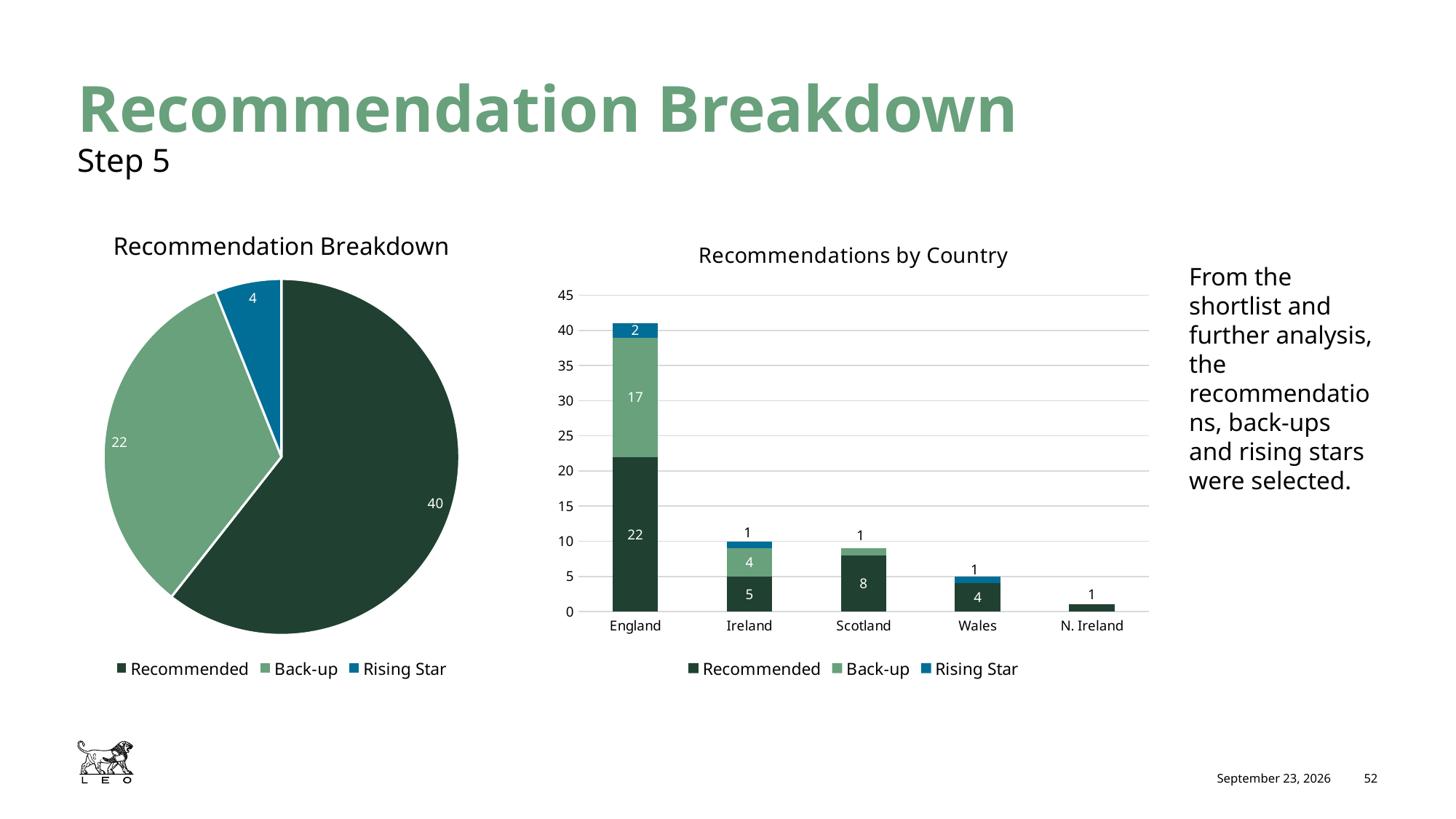
In the Recommendations by Country chart, what is the Recommended value for Scotland? 8 In the Recommendations by Country chart, which country has the lowest total? N. Ireland How many series does the legend of the Recommendations by Country chart list? 3 What kind of chart is the Recommendation Breakdown chart on the left? Pie chart In the Recommendations by Country chart, how many countries are shown on the x axis? 5 In the Recommendation Breakdown pie chart, which category has the largest slice? Recommended In the Recommendations by Country chart, is the Recommended value for Wales larger or smaller than the Recommended value for Ireland? Smaller In the Recommendation Breakdown pie chart, what is the difference between the Recommended and Rising Star values? 36 In the Recommendation Breakdown pie chart, what is the value for Back-up? 22 In the Recommendations by Country chart, what is the total of the stacked bar for Ireland? 10 In the Recommendations by Country chart, what is the total of the stacked bar for England? 41 In the Recommendations by Country chart, what is the Back-up value for England? 17